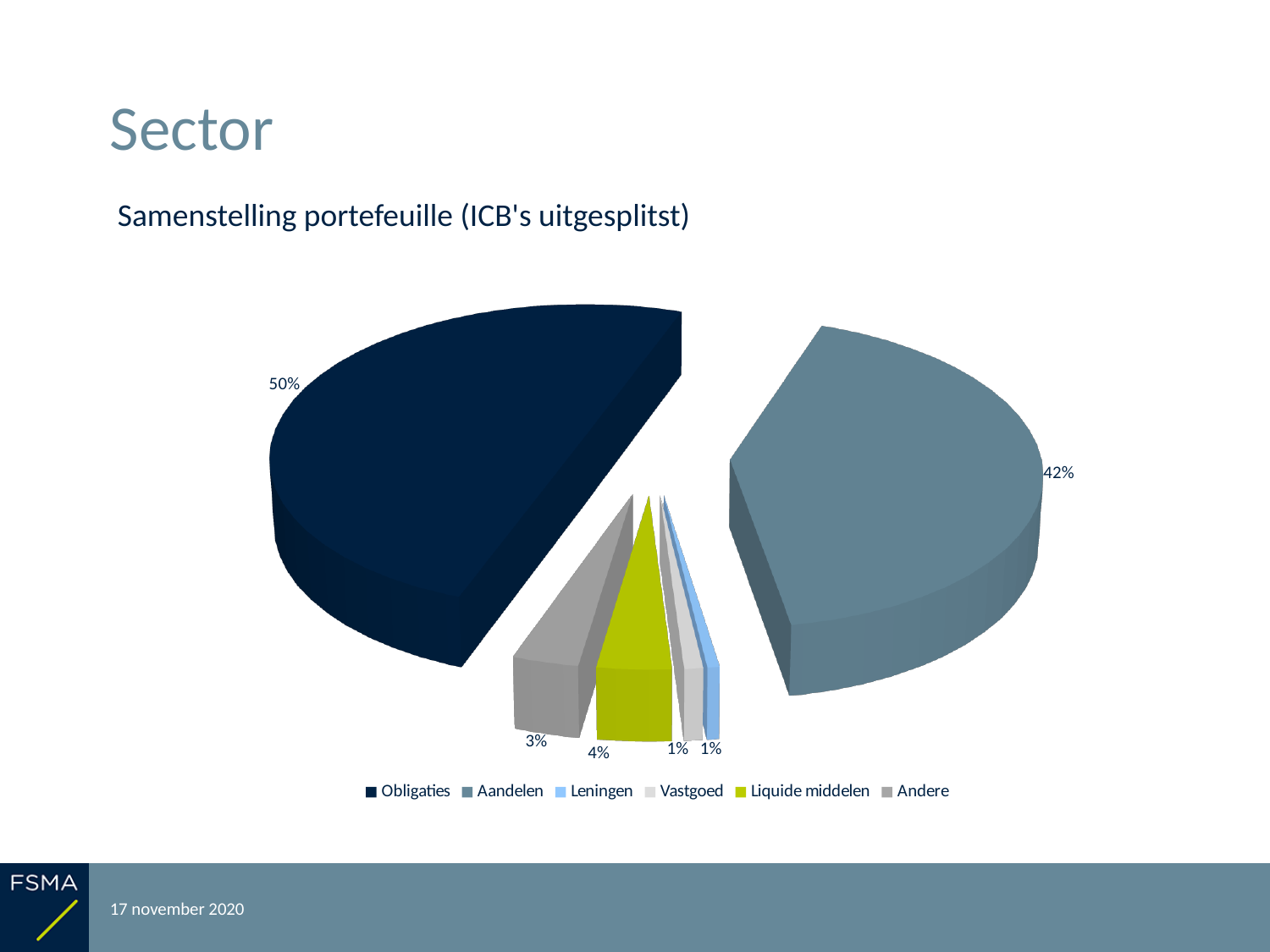
Which legend entry is shown in yellow-green? Liquide middelen What is the difference in percentage points between Obligaties and Aandelen? 8 Which is larger, Liquide middelen or Andere? Liquide middelen How many categories does the legend list? 6 What is the title of the chart? Samenstelling portefeuille (ICB's uitgesplitst) What percentage is shown for Andere? 3% What percentage is shown for Vastgoed? 1% What kind of chart is shown on the slide? Pie chart What share of the portfolio is Obligaties? 50% Which category has the largest slice of the pie? Obligaties What percentage is shown for Liquide middelen? 4% What share of the portfolio is Aandelen? 42%